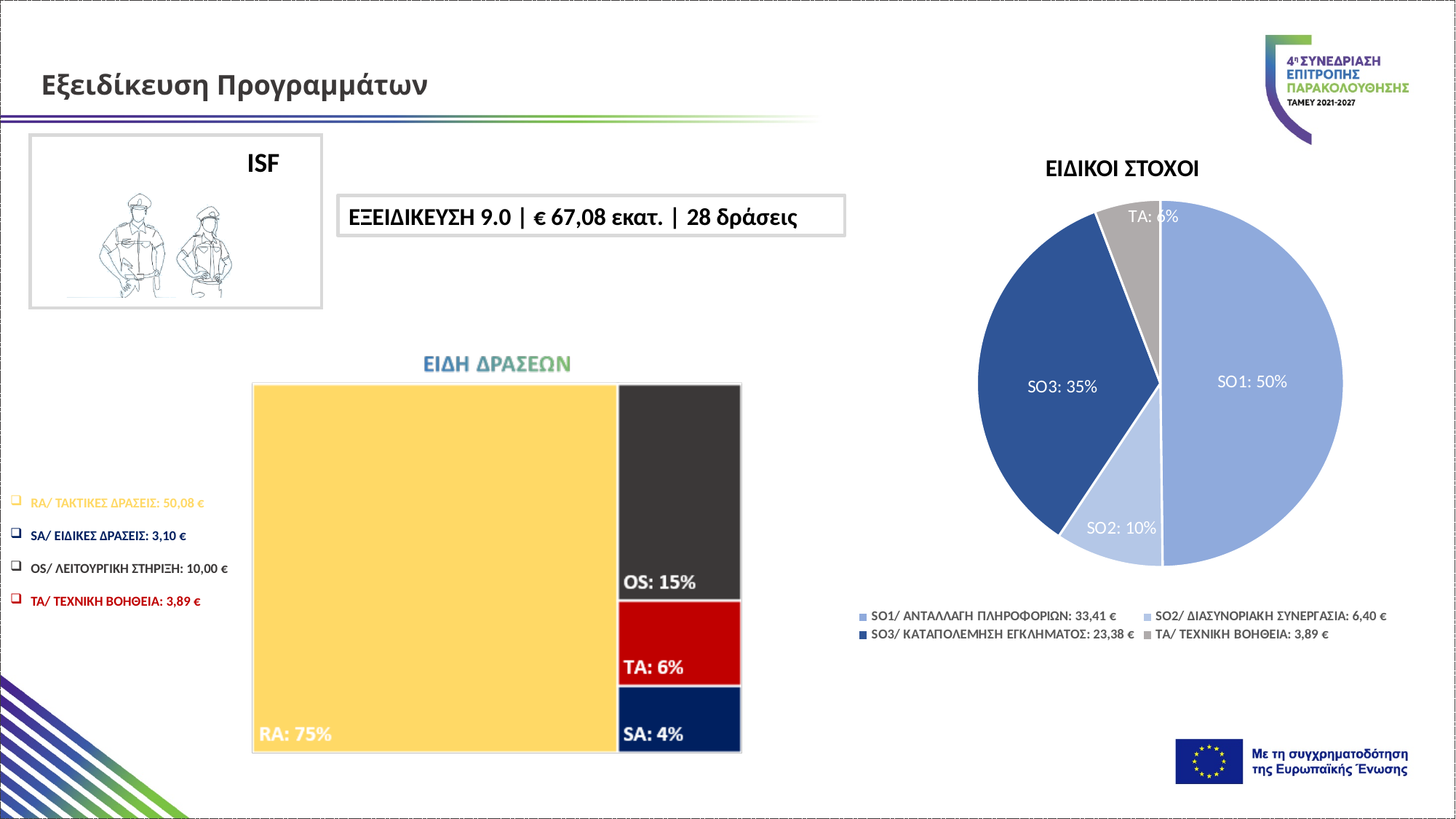
In the 'ΕΙΔΙΚΟΙ ΣΤΟΧΟΙ' pie chart, what share does SO3 have? 35% In the 'ΕΙΔΙΚΟΙ ΣΤΟΧΟΙ' pie chart, what is the difference in percentage points between SO1 and SO2? 40 In the 'ΕΙΔΙΚΟΙ ΣΤΟΧΟΙ' pie chart, which slice is the largest? SO1 In the 'ΕΙΔΙΚΟΙ ΣΤΟΧΟΙ' pie chart, which slice is the smallest? TA In the 'ΕΙΔΙΚΟΙ ΣΤΟΧΟΙ' pie chart, how many slices are there? 4 In the 'ΕΙΔΗ ΔΡΑΣΕΩΝ' chart, what percentage is shown for RA? 75% In the 'ΕΙΔΗ ΔΡΑΣΕΩΝ' chart, what percentage is shown for OS? 15% In the 'ΕΙΔΙΚΟΙ ΣΤΟΧΟΙ' chart legend, what amount is shown for SO3/ ΚΑΤΑΠΟΛΕΜΗΣΗ ΕΓΚΛΗΜΑΤΟΣ? 23,38 € In the 'ΕΙΔΗ ΔΡΑΣΕΩΝ' chart, which category has the smallest share? SA What kind of chart is the 'ΕΙΔΙΚΟΙ ΣΤΟΧΟΙ' chart? pie chart In the 'ΕΙΔΙΚΟΙ ΣΤΟΧΟΙ' pie chart, what share does SO1 have? 50% In the 'ΕΙΔΗ ΔΡΑΣΕΩΝ' chart, which is larger, TA or SA? TA